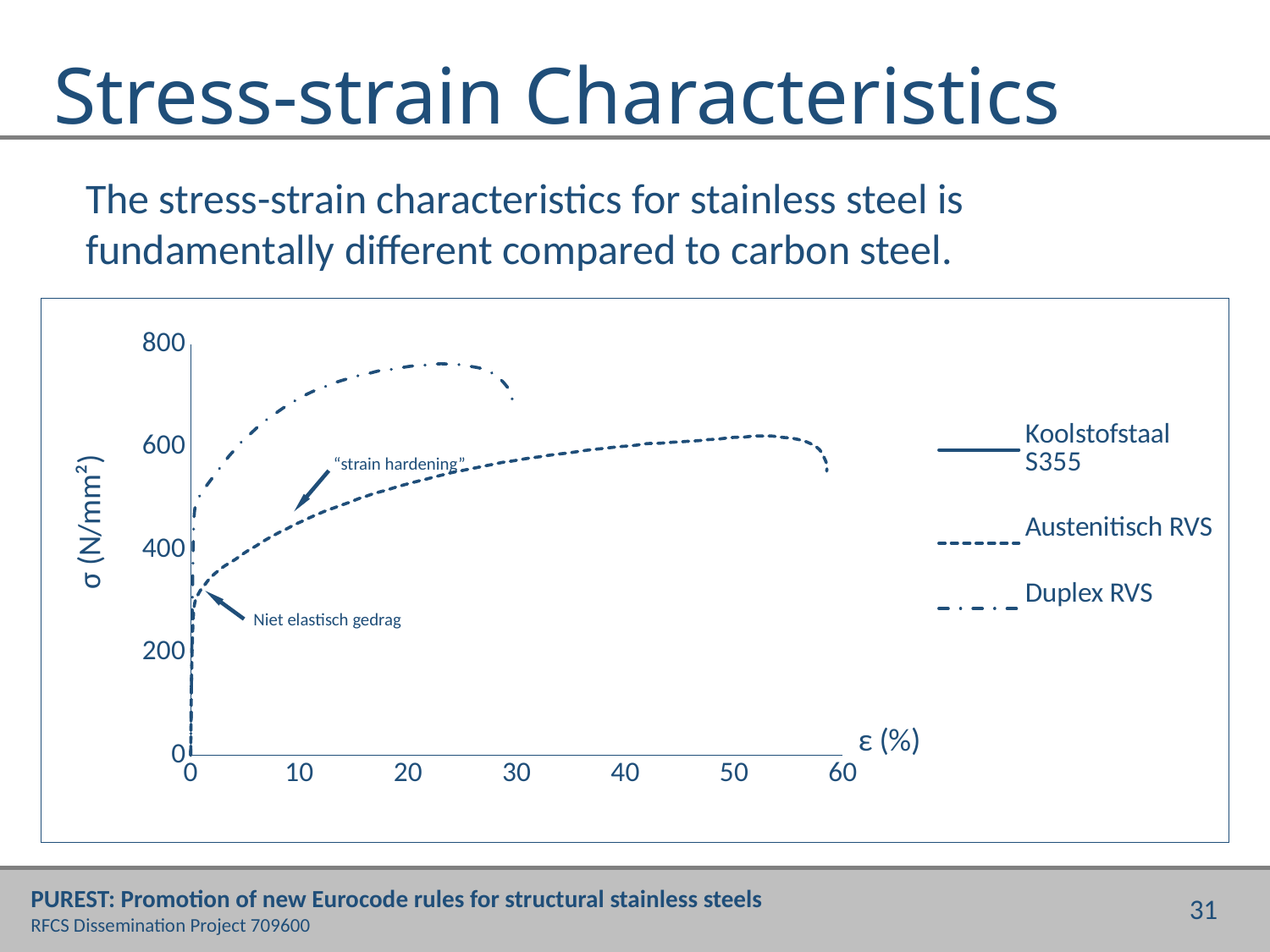
Is the stress of the Duplex RVS curve at ε = 10% greater or less than 600? greater Is the stress of the Austenitisch RVS curve at ε = 10% greater or less than 400? greater How many series does the legend list? 3 Which series extends furthest along the strain (ε) axis? Austenitisch RVS Is the peak stress of the Duplex RVS curve greater or less than 600? greater What is the label of the vertical axis? σ (N/mm²) What is the highest value shown on the vertical axis? 800 Which series reaches the highest stress value on the chart? Duplex RVS Which series are listed in the legend? Koolstofstaal S355, Austenitisch RVS, Duplex RVS At ε = 20%, which curve shows the higher stress, Duplex RVS or Austenitisch RVS? Duplex RVS What kind of chart is shown on the slide? line chart